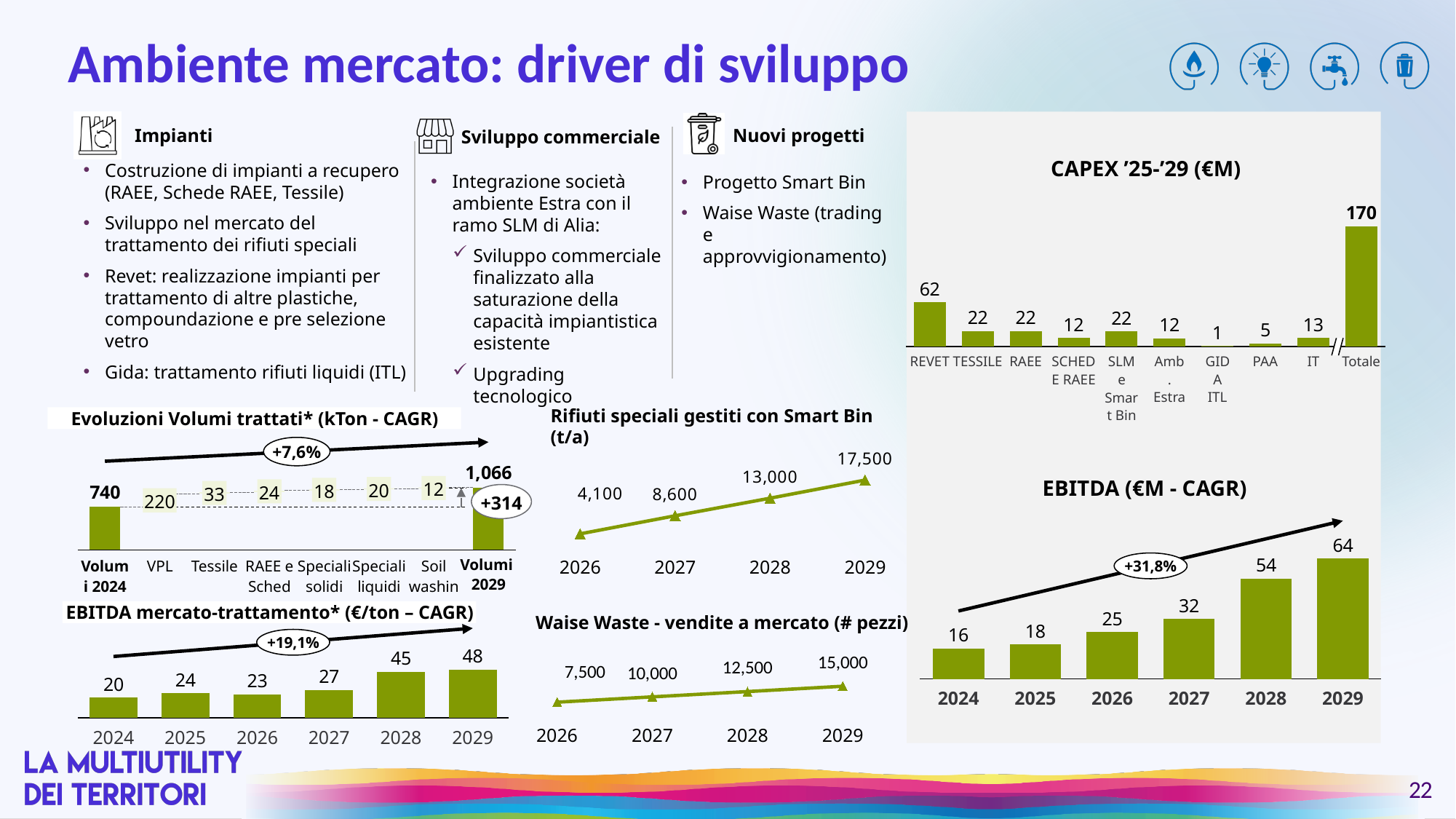
In the CAPEX '25-'29 (€M) chart, what is the value for REVET? 62 In the CAPEX '25-'29 (€M) chart, what is the difference between REVET and TESSILE? 40 In the EBITDA (€M - CAGR) chart, what is the difference between 2029 and 2024? 48 In the CAPEX '25-'29 (€M) chart, what is the value for Totale? 170 In the EBITDA (€M - CAGR) chart, what is the value for 2029? 64 What kind of chart is the Evoluzioni Volumi trattati (kTon - CAGR) chart? bar chart In the Rifiuti speciali gestiti con Smart Bin (t/a) chart, what is the value for 2028? 13,000 In the EBITDA mercato-trattamento (€/ton – CAGR) chart, which year is larger, 2025 or 2026? 2025 In the CAPEX '25-'29 (€M) chart, which category (excluding Totale) has the lowest value? GIDA ITL In the EBITDA (€M - CAGR) chart, what CAGR is shown on the arrow? +31,8% In the EBITDA (€M - CAGR) chart, do the values rise or fall from 2024 to 2029? rise In the Waise Waste - vendite a mercato (# pezzi) chart, how many years are plotted? 4